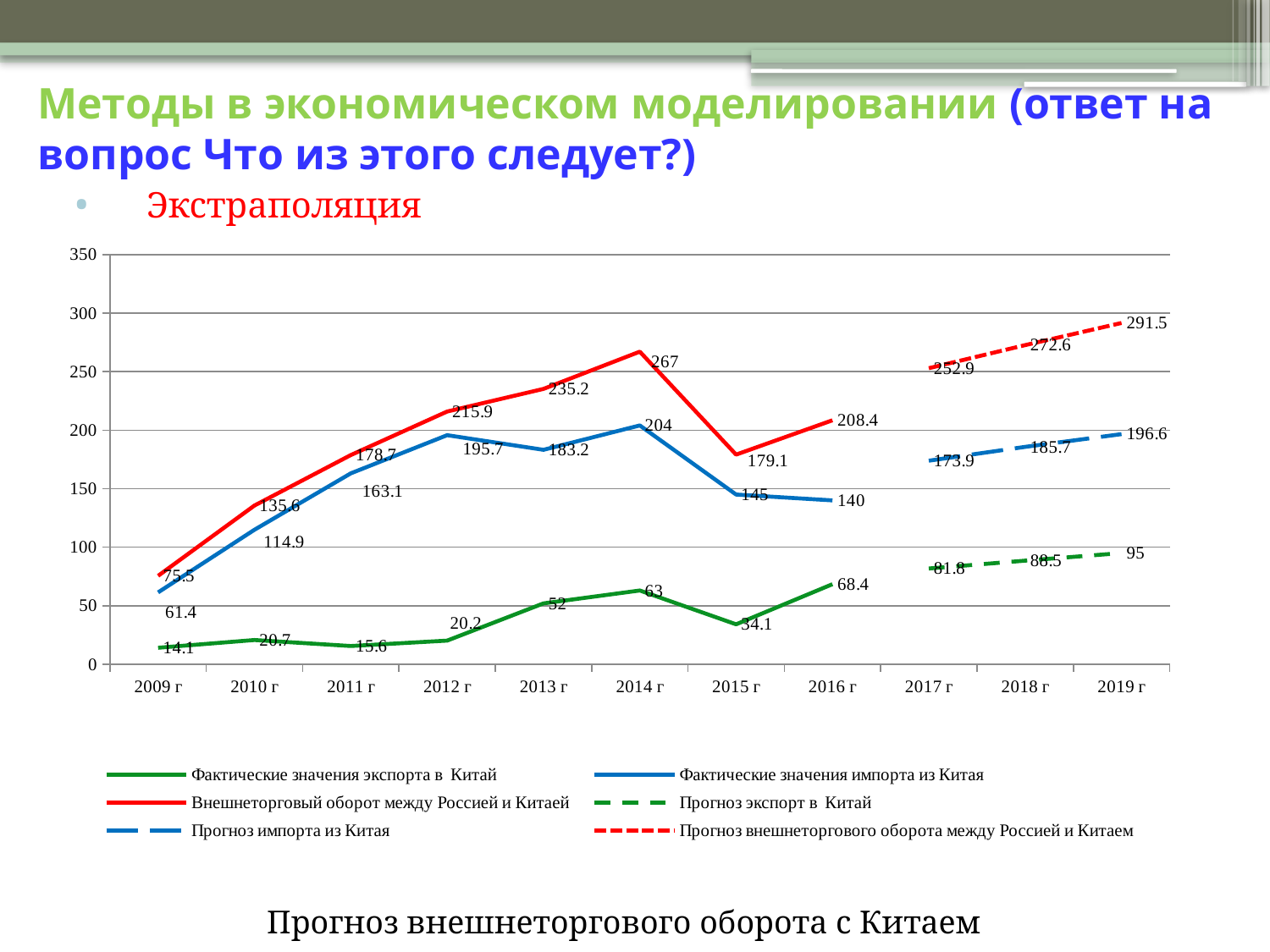
What type of chart is shown on the slide? line chart What is the forecast value of Прогноз внешнеторгового оборота между Россией и Китаем for 2019 г? 291.5 In which year does Фактические значения экспорта в Китай reach its lowest value? 2009 г Does the Прогноз импорта из Китая series rise or fall from 2017 г to 2019 г? rise How many years are shown on the x axis? 11 What is the value of Фактические значения импорта из Китая in 2012 г? 195.7 In which year does Фактические значения импорта из Китая reach its highest value? 2014 г What is the caption below the chart? Прогноз внешнеторгового оборота с Китаем Which is larger in 2016 г: Фактические значения импорта из Китая or Фактические значения экспорта в Китай? Фактические значения импорта из Китая What is the value of Внешнеторговый оборот между Россией и Китаем in 2014 г? 267 What is the difference between Внешнеторговый оборот между Россией и Китаем in 2014 г and in 2015 г? 87.9 How many series does the legend list? 6